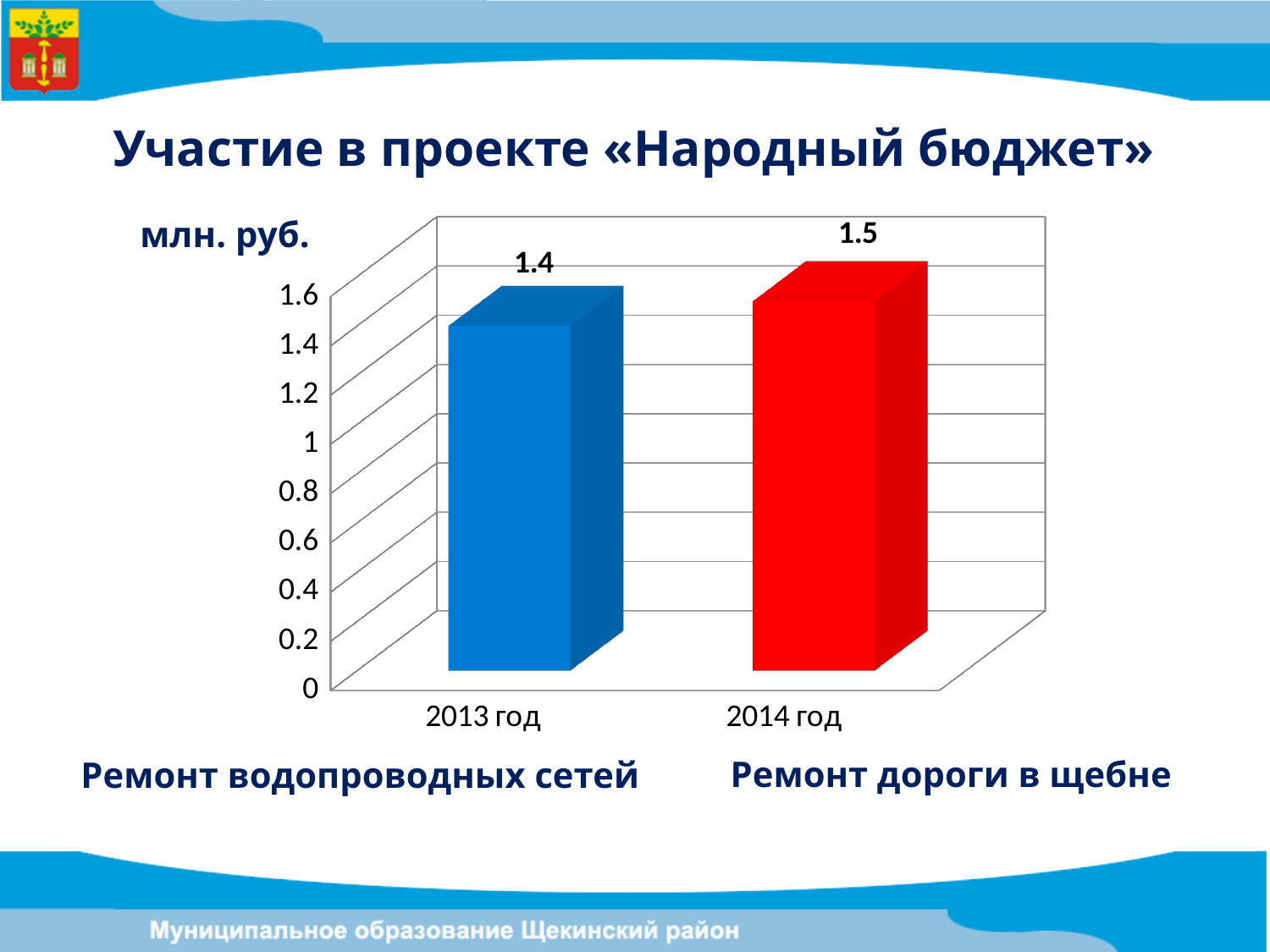
Which year has the lower value? 2013 год What is the value for 2013 год? 1.4 Is the value for 2014 год larger or smaller than the value for 2013 год? larger Is the value for 2013 год greater or less than 1? greater How many categories are shown on the x axis? 2 What unit is shown above the vertical axis of the chart? млн. руб. What is the value for 2014 год? 1.5 What is the difference between the values for 2014 год and 2013 год? 0.1 What kind of chart is shown on the slide? bar chart What colour is the bar for 2014 год? red Do the values rise or fall from 2013 год to 2014 год? rise Which year has the higher value? 2014 год